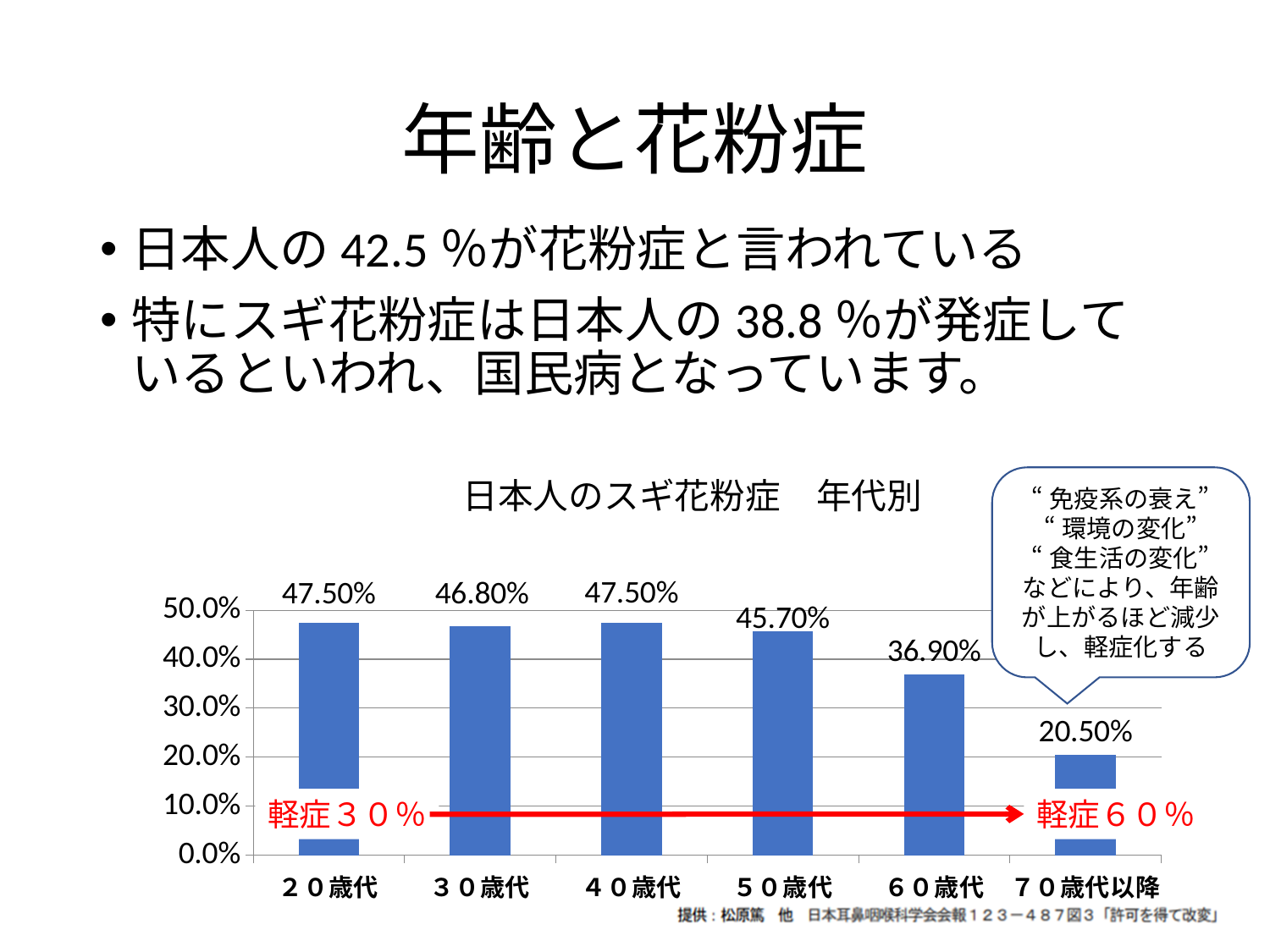
Which is larger, the value for ５０歳代 or the value for ６０歳代? ５０歳代 What is the value for ５０歳代? 45.70% What is the title of the chart? 日本人のスギ花粉症 年代別 Is the value for ６０歳代 greater or less than 40.0%? less How many age groups are shown on the x axis? 6 What is the difference between the values for ６０歳代 and ７０歳代以降? 16.40% What is the difference between the values for ２０歳代 and ５０歳代? 1.80% What is the value for ７０歳代以降? 20.50% Which age group has the lowest value? ７０歳代以降 What kind of chart is shown on the slide? bar chart What is the value for ６０歳代? 36.90% What is the value for ３０歳代? 46.80%